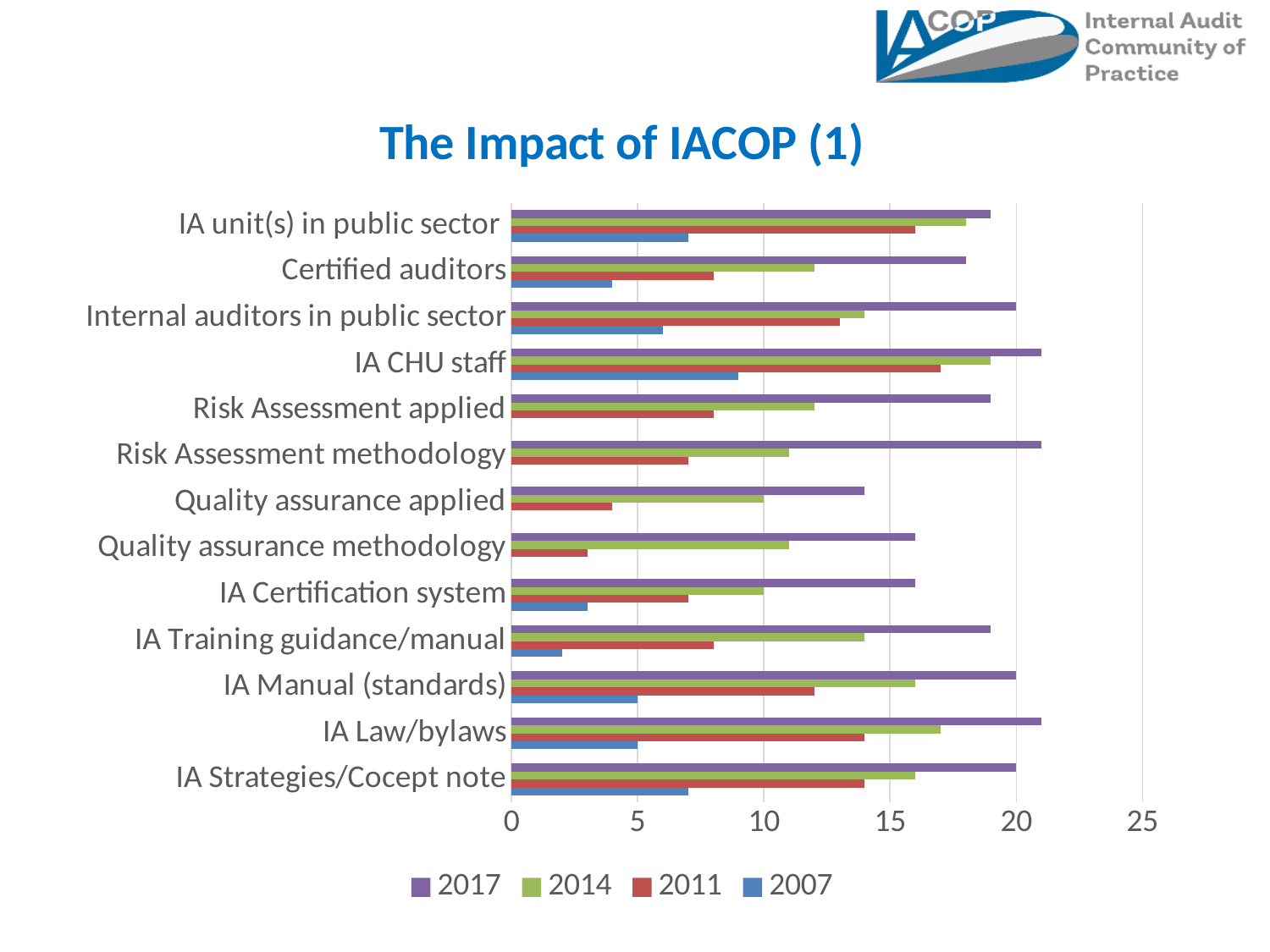
What is the title of the slide's chart? The Impact of IACOP (1) Which years are listed in the chart legend? 2017, 2014, 2011, 2007 Is the 2011 value for Quality assurance methodology greater or less than 5? less Is the 2017 value for Internal auditors in public sector greater or less than 15? greater For IA CHU staff, which series has the highest value? 2017 What kind of chart is shown on the slide? Bar chart Is the 2007 value for IA Training guidance/manual greater or less than 5? less How many series does the legend list? 4 For IA unit(s) in public sector, which is larger: the 2017 value or the 2007 value? 2017 How many categories are plotted on the chart? 13